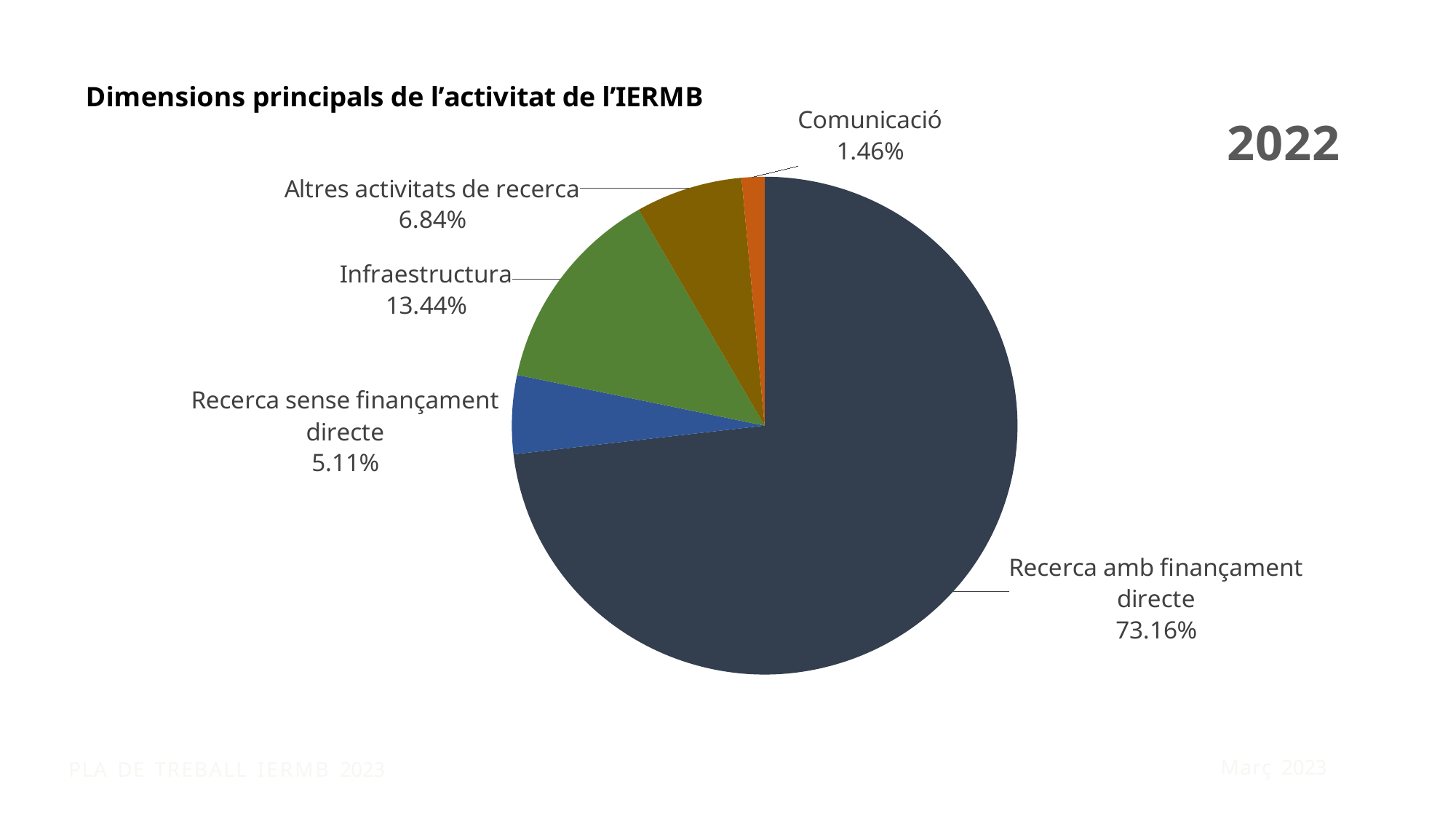
What is the share for Comunicació? 1.46% What type of chart is shown on the slide? Pie chart What is the title of the chart? Dimensions principals de l'activitat de l'IERMB Which is larger, Infraestructura or Altres activitats de recerca? Infraestructura What is the difference in percentage points between Infraestructura and Recerca sense finançament directe? 8.33 What is the share for Recerca amb finançament directe? 73.16% Which category has the smallest slice of the pie? Comunicació What is the share for Infraestructura? 13.44% What is the share for Altres activitats de recerca? 6.84% How many categories are shown in the pie chart? 5 Which category has the largest slice of the pie? Recerca amb finançament directe What is the share for Recerca sense finançament directe? 5.11%